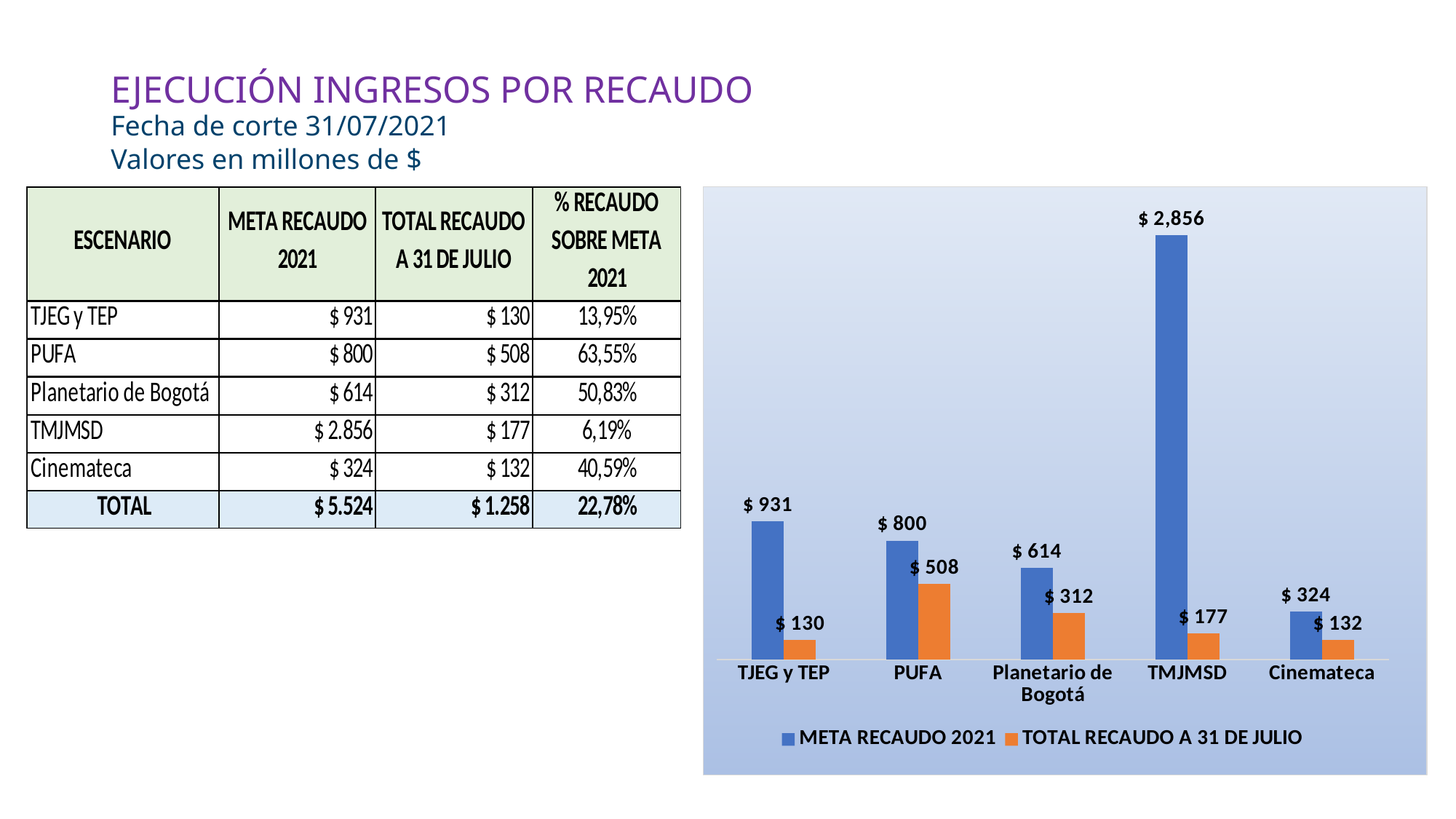
What is the difference between the META RECAUDO 2021 values for TJEG y TEP and PUFA in the chart? $ 131 What kind of chart is shown on the slide? Bar chart Which is larger in the chart: the TOTAL RECAUDO A 31 DE JULIO value for TMJMSD or for Cinemateca? TMJMSD What colour are the META RECAUDO 2021 bars in the chart? Blue What is the META RECAUDO 2021 value for TMJMSD in the chart? $ 2,856 How many series does the chart legend list? 2 What is the difference between the META RECAUDO 2021 and TOTAL RECAUDO A 31 DE JULIO values for Planetario de Bogotá? $ 302 What is the TOTAL RECAUDO A 31 DE JULIO value for PUFA in the chart? $ 508 Which category has the highest META RECAUDO 2021 value in the chart? TMJMSD How many categories are shown on the x axis of the chart? 5 Which category has the lowest TOTAL RECAUDO A 31 DE JULIO value in the chart? TJEG y TEP What is the META RECAUDO 2021 value for Cinemateca in the chart? $ 324